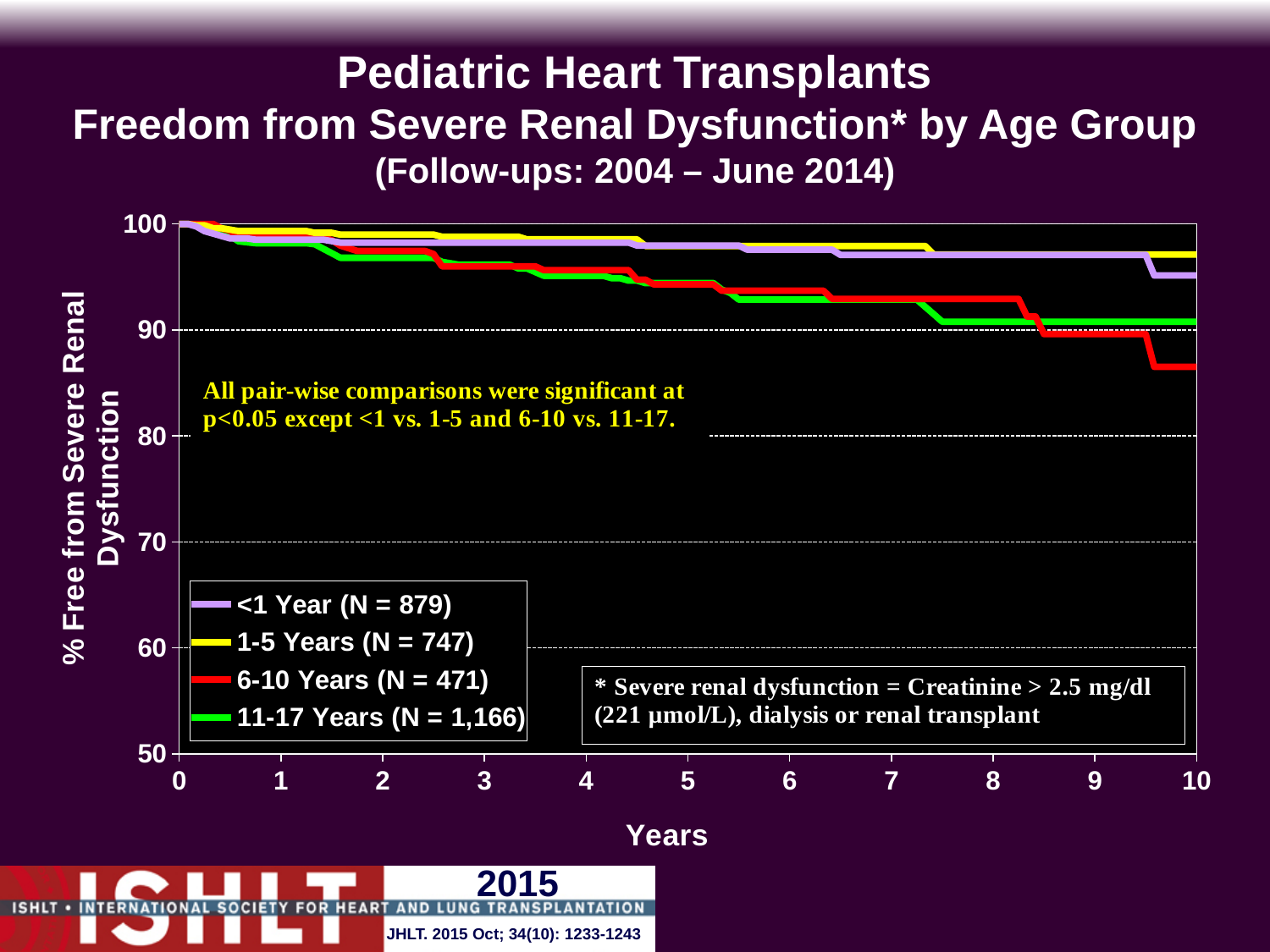
Which age group has the lowest freedom from severe renal dysfunction at 10 years? 6-10 Years Is the value for the 11-17 Years group at 5 years greater or less than 90? greater What is the N for the 11-17 Years group shown in the legend? 1,166 How many series does the legend list? 4 Do the curves rise or fall as years since transplant increase? fall Is the value for the 1-5 Years group at 10 years greater or less than 90? greater At 10 years, which is higher: the <1 Year group or the 6-10 Years group? <1 Year Is the value for the 6-10 Years group at 10 years greater or less than 90? less At 10 years, which is higher: the 11-17 Years group or the 6-10 Years group? 11-17 Years What is the label of the x axis? Years What kind of chart is shown on the slide? line chart What value do all four curves start at when Years = 0? 100